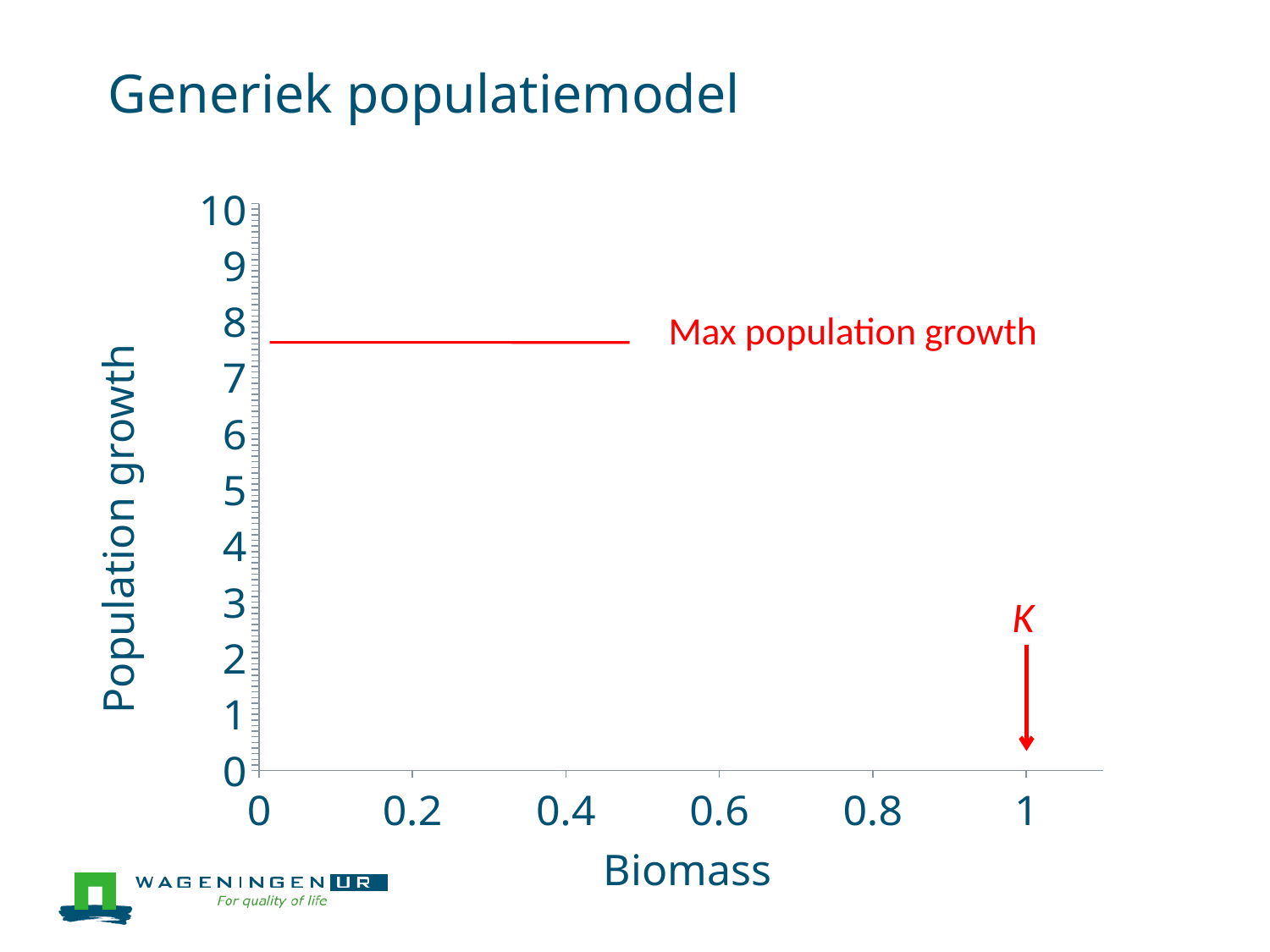
Is the red horizontal line labelled 'Max population growth' at a value greater or less than 9 on the Population growth axis? less What is the highest value shown on the Population growth axis? 10 Is the red horizontal line labelled 'Max population growth' at a value greater or less than 7 on the Population growth axis? greater What is the highest value shown on the Biomass axis? 1 At which Biomass value does the red arrow labelled K point on the x axis? 1 What is the label of the y axis on the chart? Population growth What is the label of the x axis on the chart? Biomass Is the red horizontal line labelled 'Max population growth' at a value greater or less than 5 on the Population growth axis? greater What text labels the red horizontal line on the chart? Max population growth